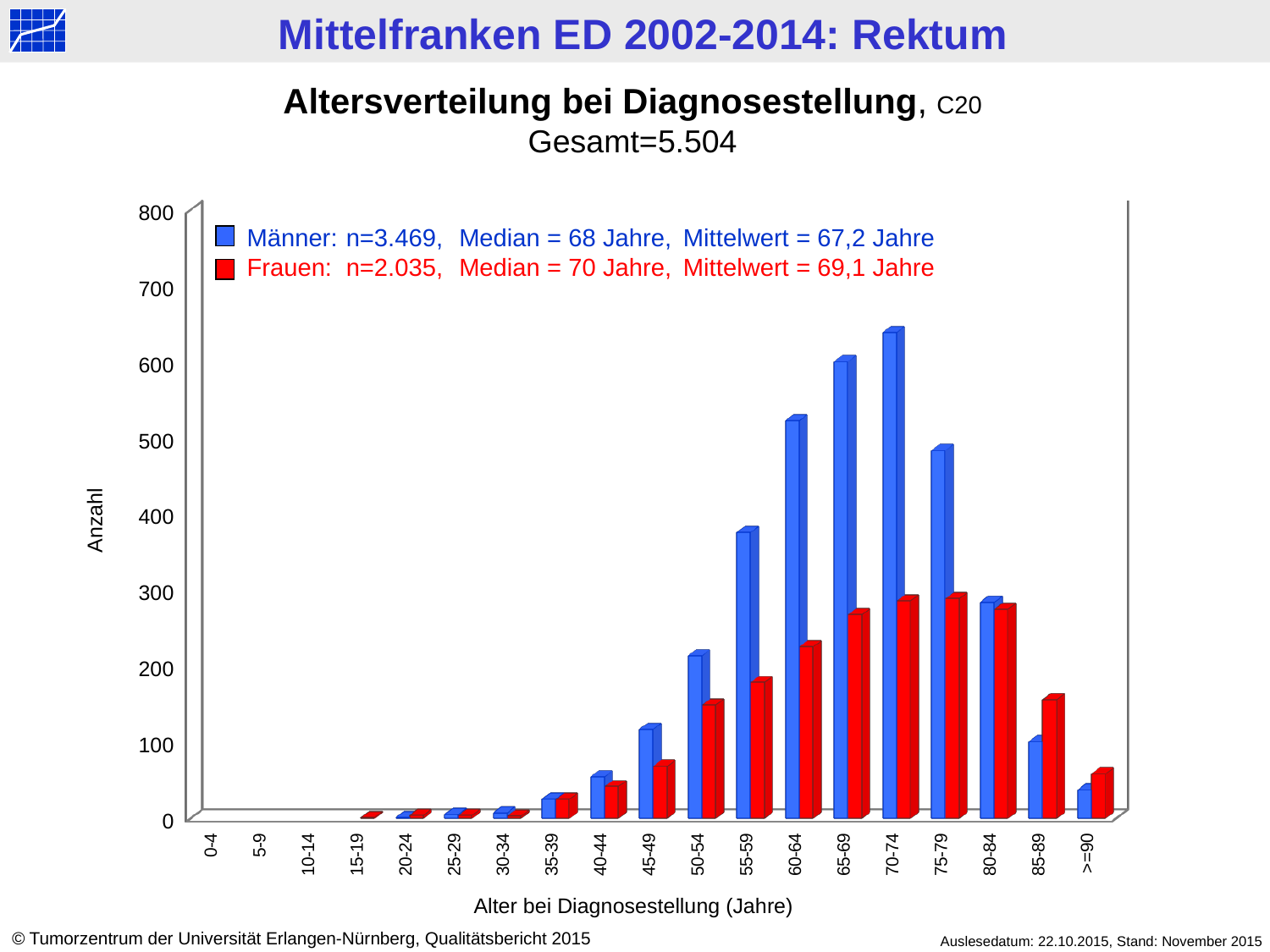
In the 85-89 age group, which series has the larger value, Männer or Frauen? Frauen What kind of chart is shown on the slide? bar chart Is the value for Frauen in the 60-64 age group greater or less than 200? greater Do the values for Männer rise or fall from the 35-39 age group to the 70-74 age group? rise In the 70-74 age group, which series has the larger value, Männer or Frauen? Männer In which age group is the value for Männer highest? 70-74 How many age categories are shown on the x axis? 19 According to the legend, what is the median age for Frauen? 70 Jahre Is the value for Männer in the 55-59 age group greater or less than 400? less How many series does the legend list? 2 Is the value for Frauen in the 85-89 age group greater or less than 100? greater